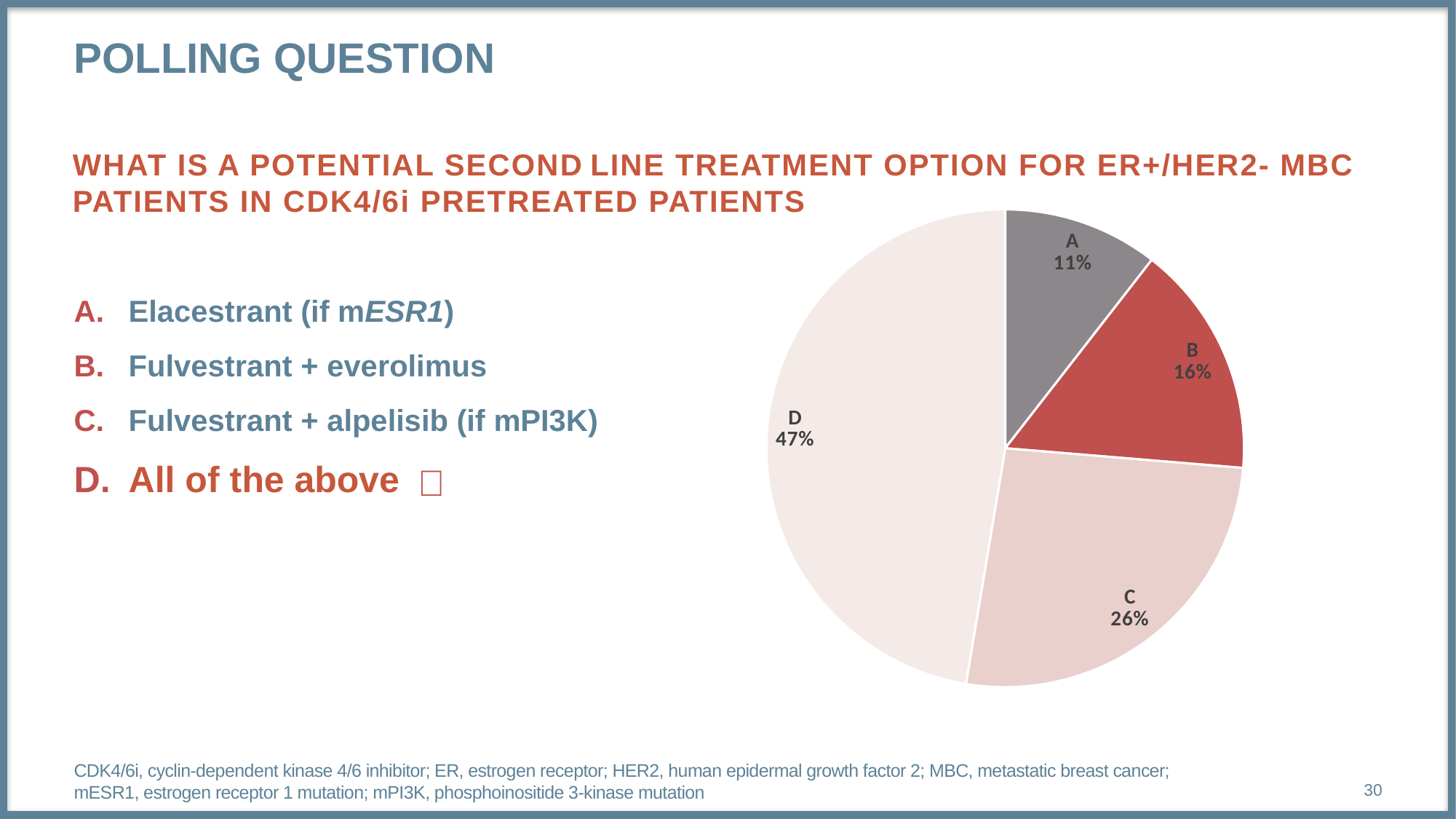
What percentage of the pie is slice C? 26% Which is larger, slice B or slice C? C How many slices does the pie chart have? 4 Which slice of the pie is coloured dark grey? A What kind of chart is shown on the slide? pie chart Which slice of the pie is the largest? D What percentage of the pie is slice B? 16% What percentage of the pie is slice A? 11% What percentage of the pie is slice D? 47% What is the difference in percentage points between slice B and slice A? 5 Which slice of the pie is the smallest? A What is the difference in percentage points between slice D and slice C? 21